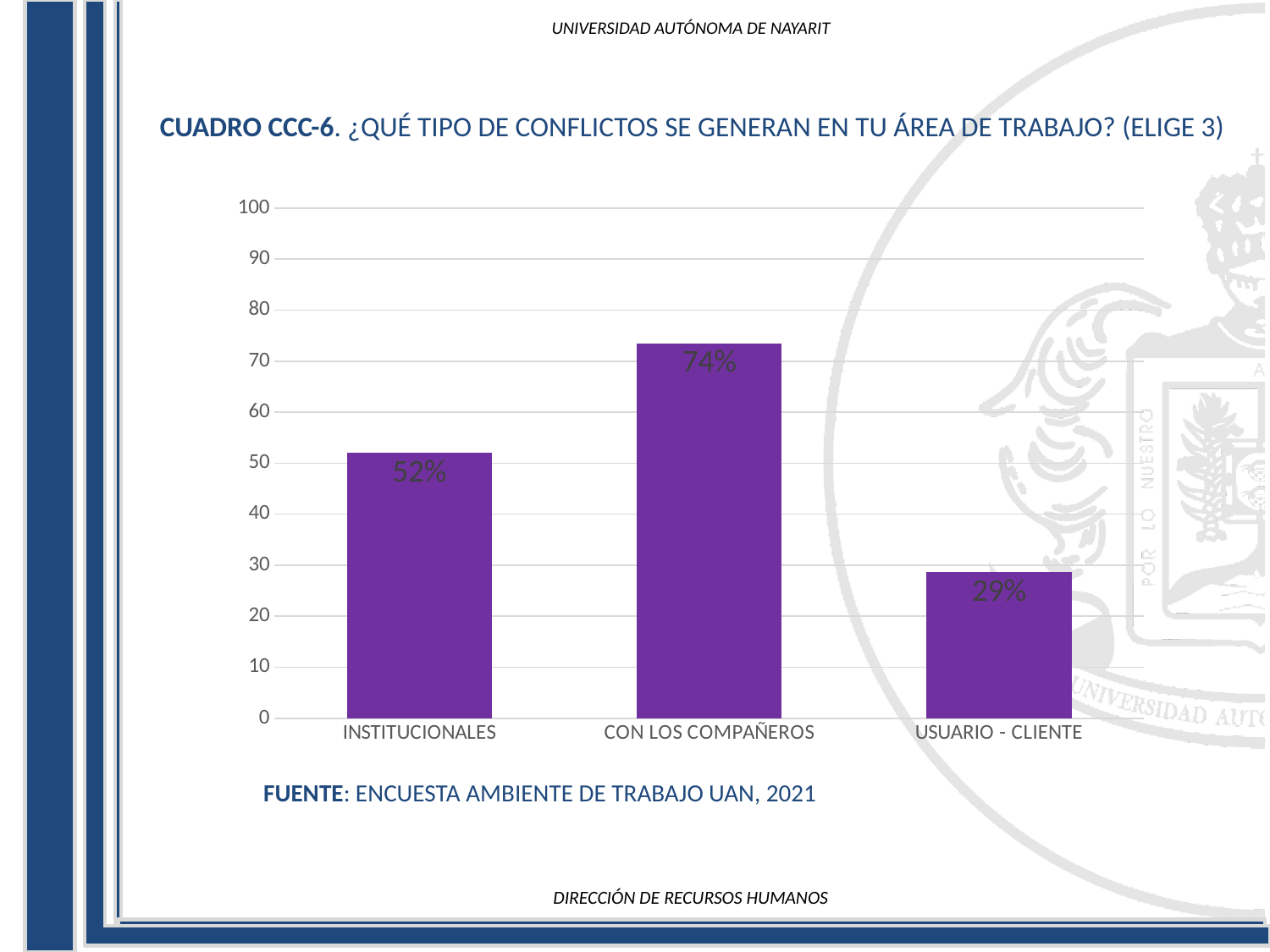
What is the value for CON LOS COMPAÑEROS? 74% What is the difference between the values for INSTITUCIONALES and USUARIO - CLIENTE? 23% Is the value for CON LOS COMPAÑEROS greater or less than 60? greater What is the value for USUARIO - CLIENTE? 29% How many categories are shown in the chart? 3 What is the difference between the values for CON LOS COMPAÑEROS and INSTITUCIONALES? 22% What kind of chart is shown on the slide? bar chart Which is larger, the value for INSTITUCIONALES or the value for USUARIO - CLIENTE? INSTITUCIONALES Which category has the highest value? CON LOS COMPAÑEROS What is the value for INSTITUCIONALES? 52% Which category has the lowest value? USUARIO - CLIENTE What source is cited below the chart? ENCUESTA AMBIENTE DE TRABAJO UAN, 2021